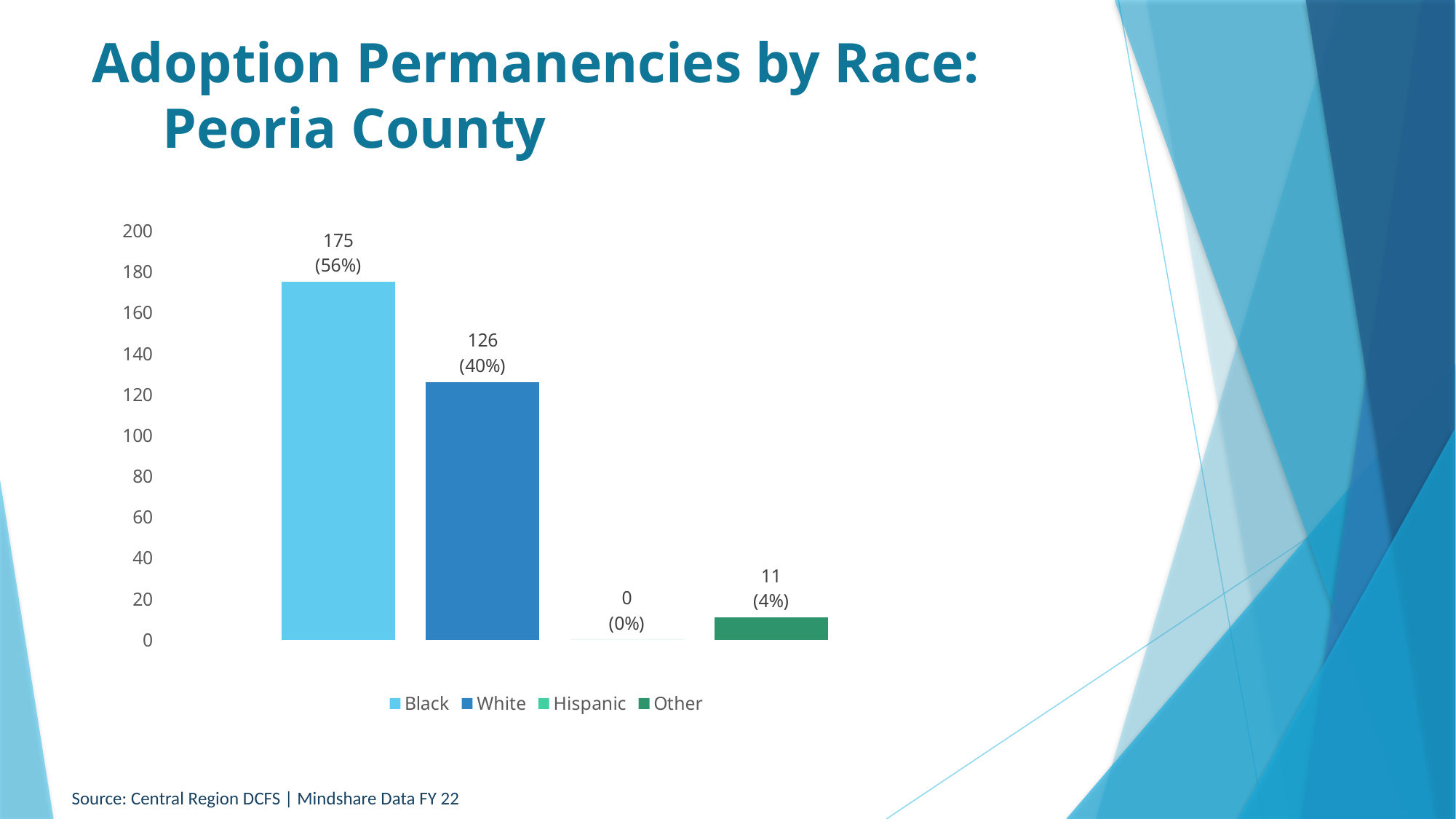
What is the difference between the values for Black and White? 49 How many series does the legend list? 4 How many adoption permanencies are shown for Black in Peoria County? 175 What kind of chart is shown on the slide? Bar chart Which race has the lowest number of adoption permanencies? Hispanic What is the value shown for Other? 11 What is the title of the chart on the slide? Adoption Permanencies by Race: Peoria County Which race has the highest number of adoption permanencies? Black Which is larger, the value for White or the value for Other? White What percentage of adoption permanencies is shown for White? 40% Is the value for White greater or less than 140? less What is the value shown for Hispanic? 0